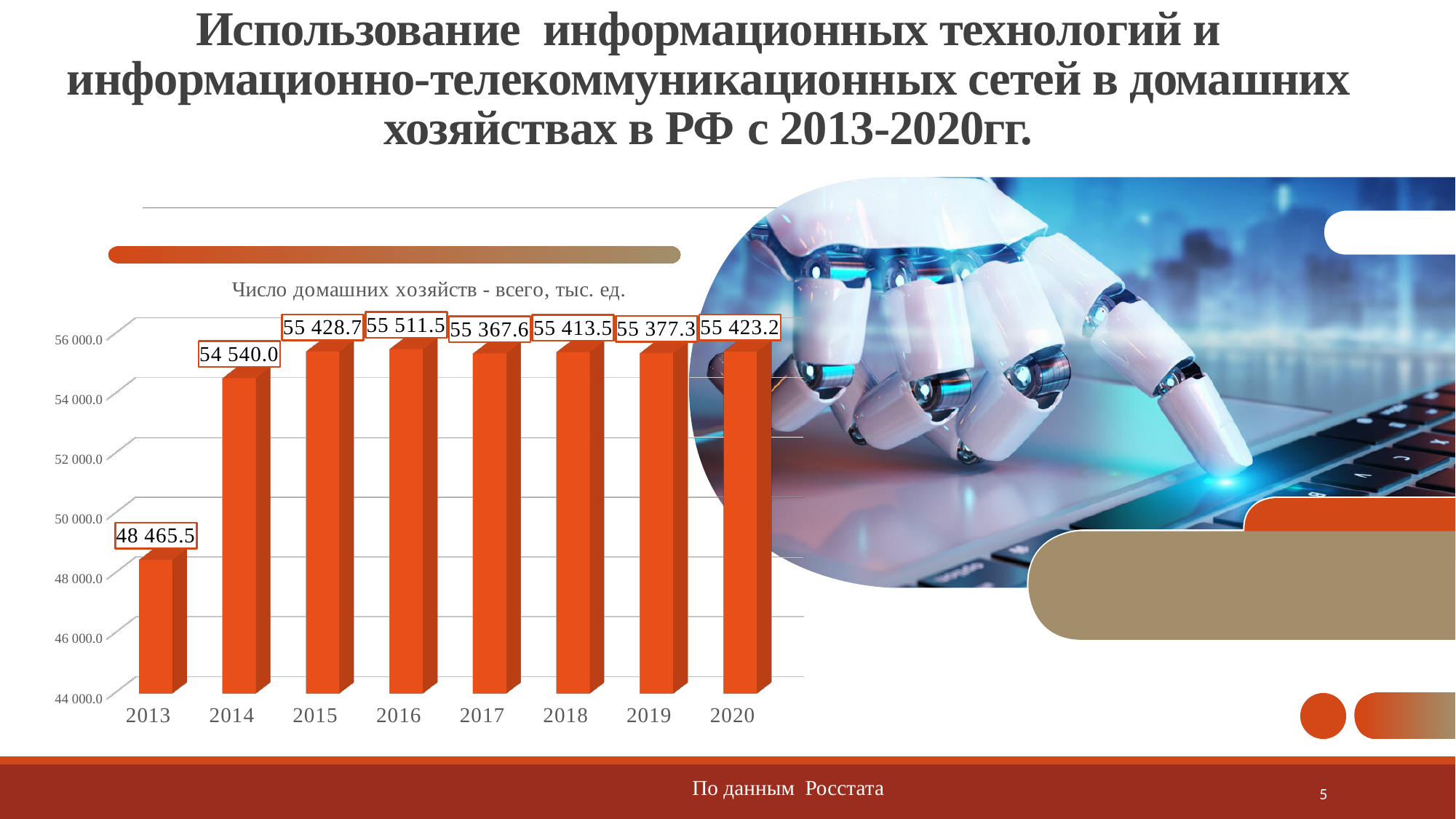
Is the value for 2013 greater or less than 50 000.0? less What is the difference between the values for 2014 and 2013? 6 074.5 Which is larger, the value for 2017 or the value for 2018? 2018 What kind of chart is shown on the slide? bar chart Do the values rise or fall from 2013 to 2016? rise What is the value for 2020 in the chart? 55 423.2 Which year has the lowest value in the chart? 2013 What is the value for 2013 in the chart 'Число домашних хозяйств - всего, тыс. ед.'? 48 465.5 What is the difference between the values for 2016 and 2015? 82.8 What is the value for 2016 in the chart? 55 511.5 Which year has the highest value in the chart? 2016 How many years are shown on the x axis of the chart? 8